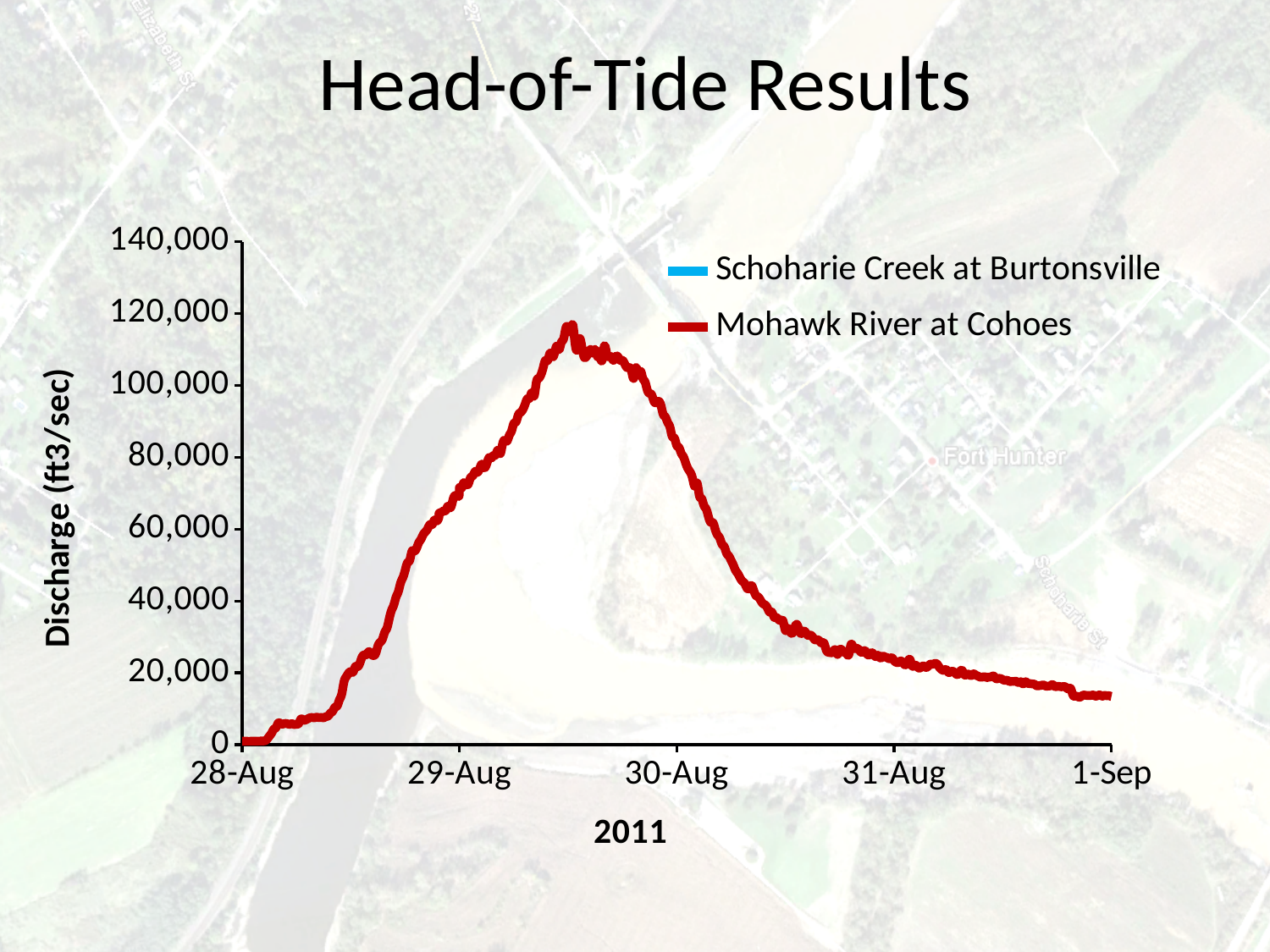
Which is larger for Mohawk River at Cohoes, the discharge on 29-Aug or on 1-Sep? 29-Aug Is the value for Mohawk River at Cohoes at the start on 28-Aug greater or less than 20,000? less Does the Mohawk River at Cohoes discharge rise or fall between 28-Aug and 29-Aug? rise What kind of chart is shown on the slide? line chart How many series does the legend list? 2 Does the Mohawk River at Cohoes discharge rise or fall between 30-Aug and 1-Sep? fall Is the peak value of the Mohawk River at Cohoes line greater or less than 100,000? greater Is the value for Mohawk River at Cohoes on 1-Sep greater or less than 20,000? less What is the title of the chart? Head-of-Tide Results What is the label of the y axis? Discharge (ft3/sec)